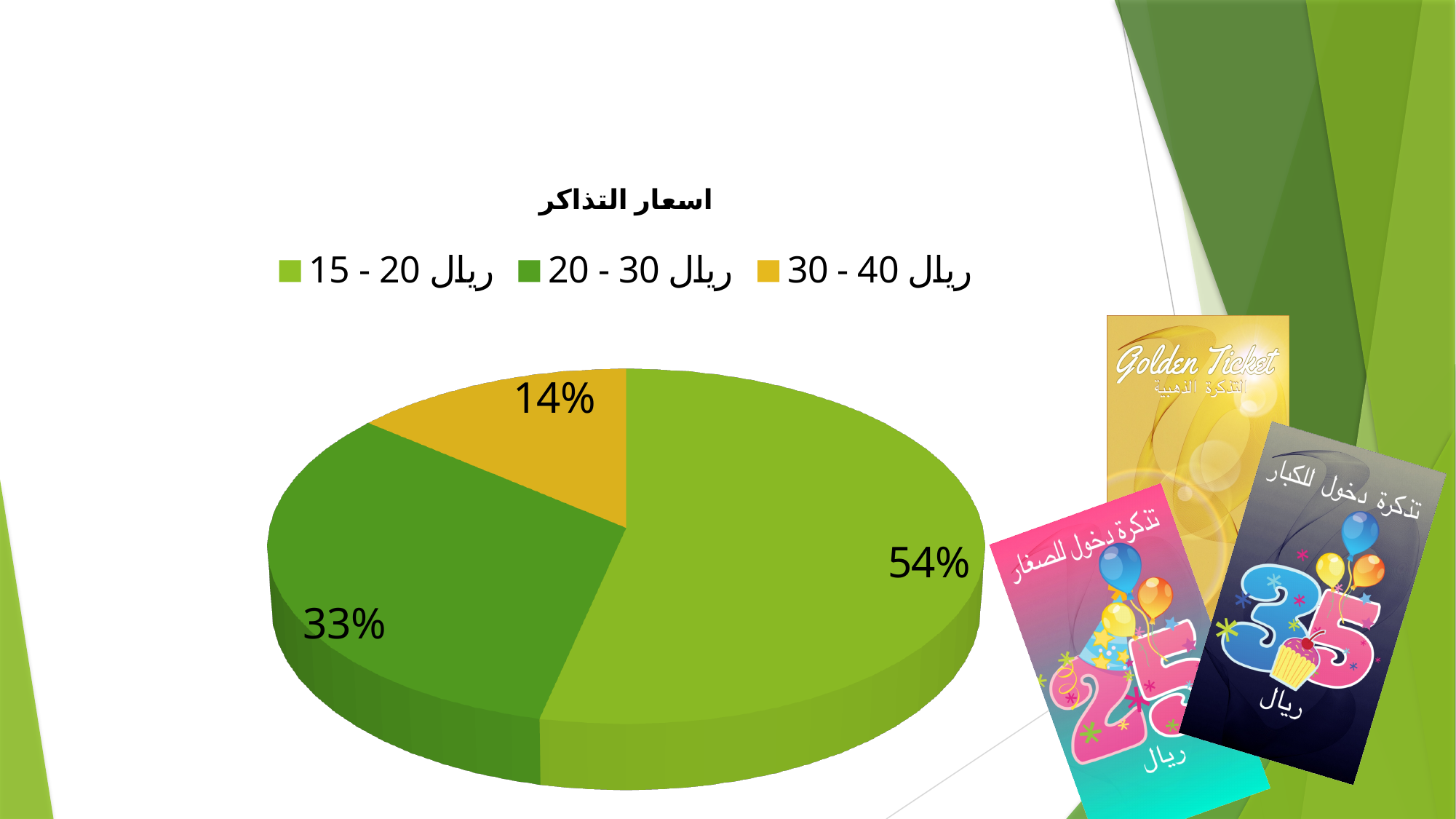
Which price range has the smallest share of the pie? 30 - 40 ريال Which slice is larger, "20 - 30 ريال" or "30 - 40 ريال"? 20 - 30 ريال What share of the pie is the "30 - 40 ريال" slice? 14% What share of the pie is the "15 - 20 ريال" slice? 54% Which price range has the largest share of the pie? 15 - 20 ريال What is the title of the chart? اسعار التذاكر What is the difference in percentage points between the "15 - 20 ريال" slice and the "20 - 30 ريال" slice? 21 What kind of chart is shown on the slide? Pie chart How many entries does the legend list? 3 How many slices does the pie chart have? 3 What share of the pie is the "20 - 30 ريال" slice? 33% What colour is the "30 - 40 ريال" slice in the pie chart? Gold